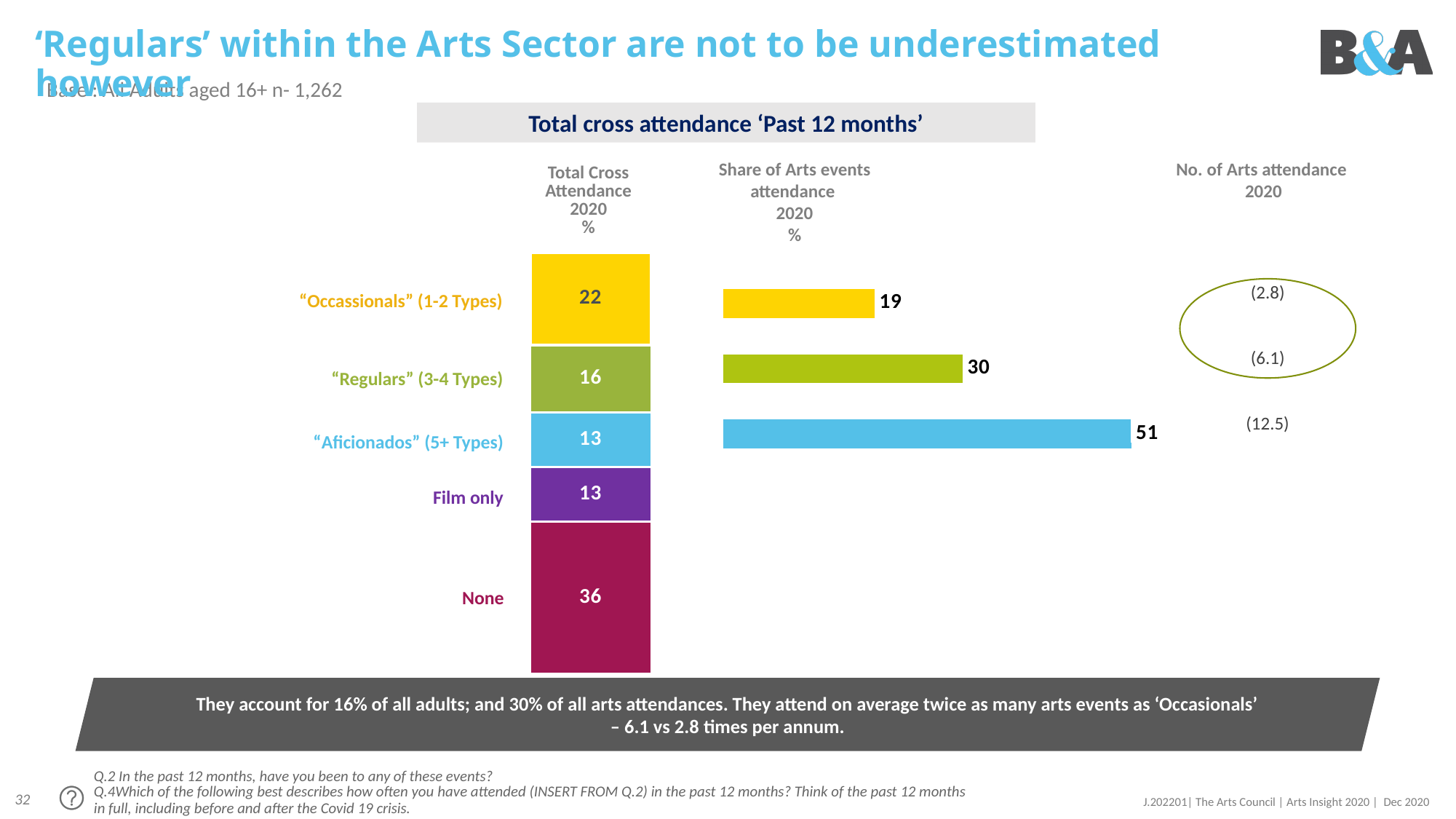
In the 'Total Cross Attendance 2020 %' stacked bar, which category has the largest segment? None In the 'No. of Arts attendance 2020' column, what is the value for "Regulars" (3-4 Types)? (6.1) What kind of chart is the 'Share of Arts events attendance 2020 %' chart? Bar chart In the 'Share of Arts events attendance 2020 %' chart, what is the difference between "Aficionados" (5+ Types) and "Regulars" (3-4 Types)? 21 In the 'Share of Arts events attendance 2020 %' chart, which category has the lowest value? "Occassionals" (1-2 Types) In the 'Total Cross Attendance 2020 %' stacked bar, what is the total of all segments? 100 In the 'Total Cross Attendance 2020 %' stacked bar, what is the difference between "Occassionals" (1-2 Types) and "Regulars" (3-4 Types)? 6 In the 'Total Cross Attendance 2020 %' stacked bar, what is the value for "Regulars" (3-4 Types)? 16 In the 'Total Cross Attendance 2020 %' stacked bar, how many segments are there? 5 In the 'Share of Arts events attendance 2020 %' chart, what is the value for "Regulars" (3-4 Types)? 30 In the 'Share of Arts events attendance 2020 %' chart, what is the value for "Aficionados" (5+ Types)? 51 In the 'Total Cross Attendance 2020 %' stacked bar, what is the value for None? 36